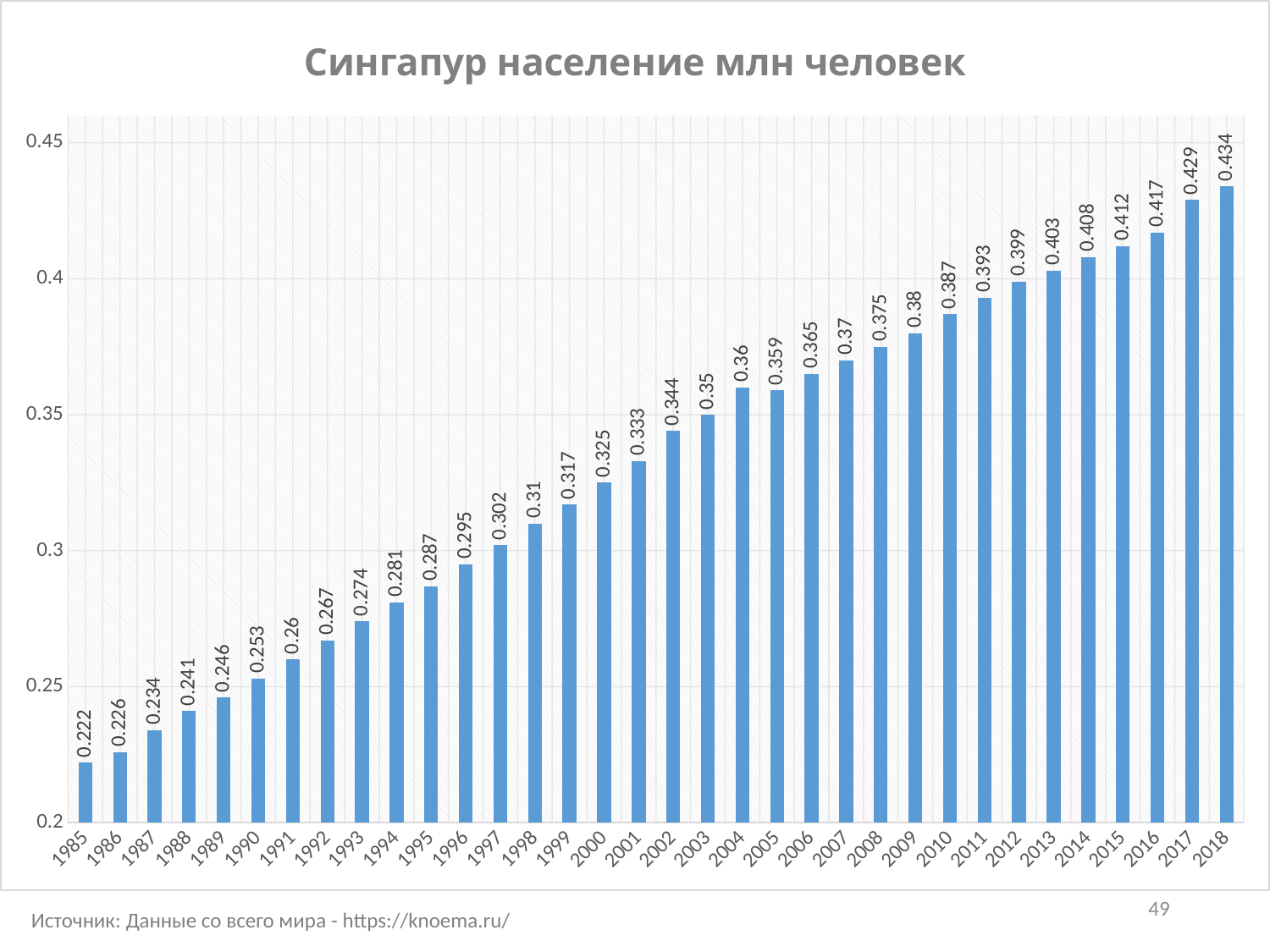
Which is larger, the value for 1995 or the value for 2010? 2010 How many years are shown on the x axis? 34 What is the value for 2000? 0.325 What is the value for 2009? 0.38 What is the value for 1985? 0.222 Which year has the highest value? 2018 What kind of chart is this? Bar chart What is the difference between the values for 2017 and 2016? 0.012 What is the difference between the values for 2018 and 1985? 0.212 What is the title of the chart? Сингапур население млн человек Which year has the lowest value? 1985 What is the value for 2018? 0.434